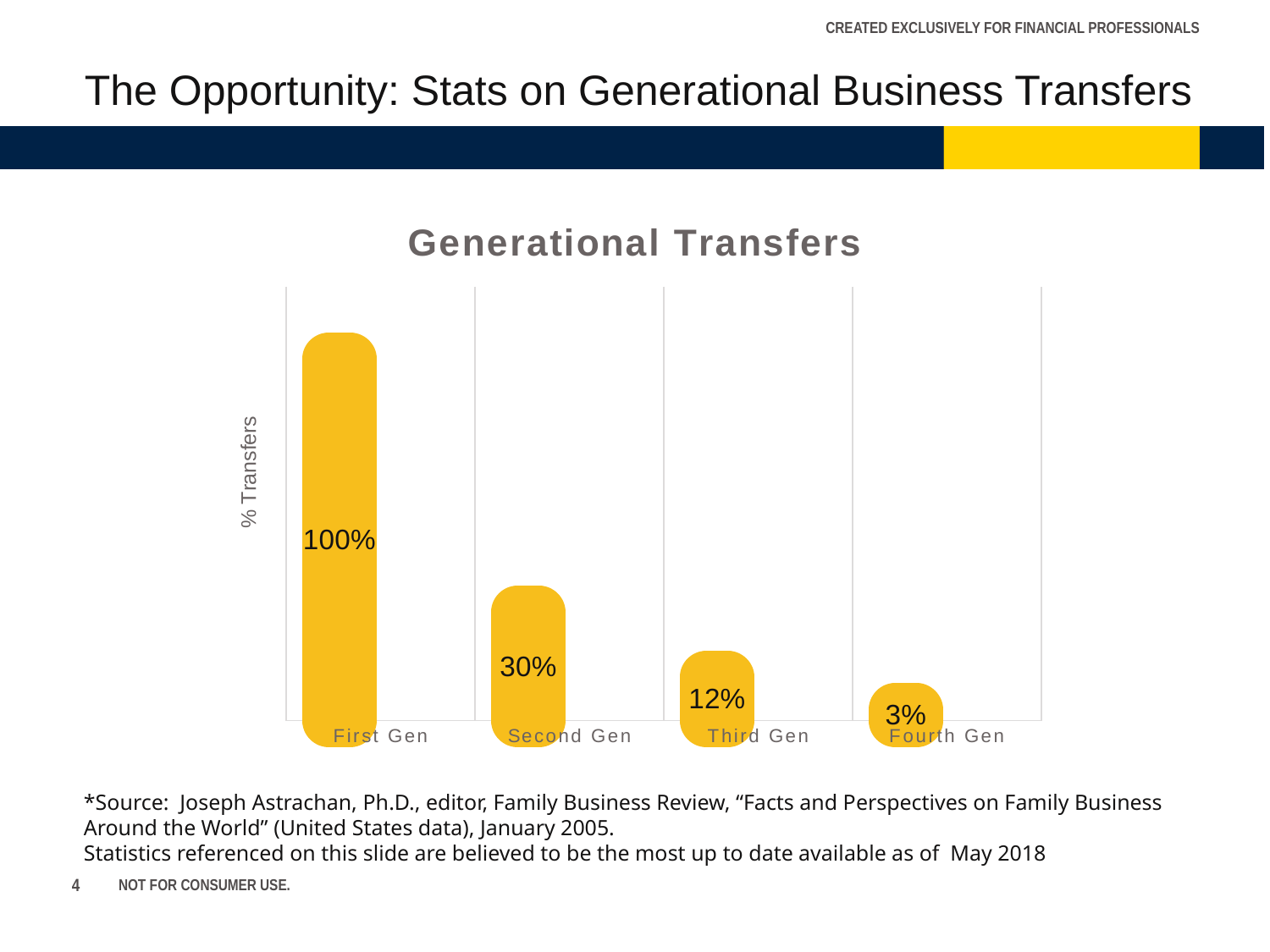
What is the difference between the values for Third Gen and Fourth Gen? 9% What is the difference between the values for First Gen and Second Gen? 70% Do the values rise or fall from First Gen to Fourth Gen? Fall What is the value for Fourth Gen? 3% How many categories are shown on the chart? 4 What is the value for First Gen? 100% Which category has the lowest value? Fourth Gen What kind of chart is shown? Bar chart What is the value for Second Gen? 30% Which category has the highest value? First Gen What is the value for Third Gen? 12% Which is larger, the value for Second Gen or the value for Third Gen? Second Gen